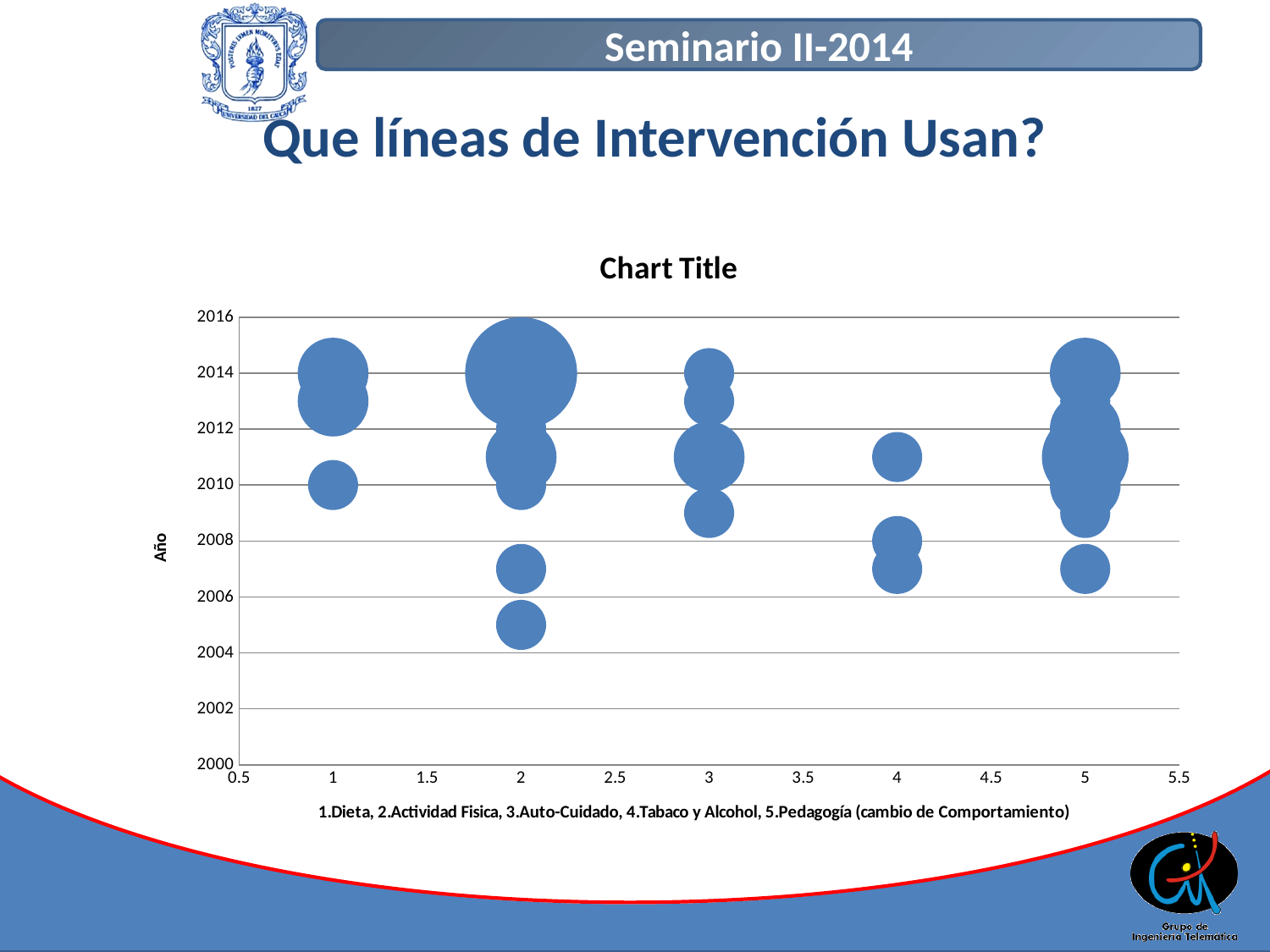
How many bubbles are plotted at x = 3 (Auto-Cuidado)? 4 What is the highest value shown on the vertical (Año) axis? 2016 How many bubbles are plotted at x = 1 (Dieta)? 3 What kind of chart is shown on the slide? bubble chart At which x value (intervention line) is the largest bubble on the chart located? 2 What is the label on the vertical axis of the chart? Año Is the lowest bubble for x = 2 (Actividad Fisica) at a year greater or less than 2006? less What is the title of the chart? Chart Title How many bubbles are plotted at x = 4 (Tabaco y Alcohol)? 3 Which intervention line has a bubble at the earliest year on the chart? 2 (Actividad Fisica) Is the highest bubble for x = 4 (Tabaco y Alcohol) at a year greater or less than 2012? less Which has more bubbles plotted: x = 2 (Actividad Fisica) or x = 4 (Tabaco y Alcohol)? x = 2 (Actividad Fisica)